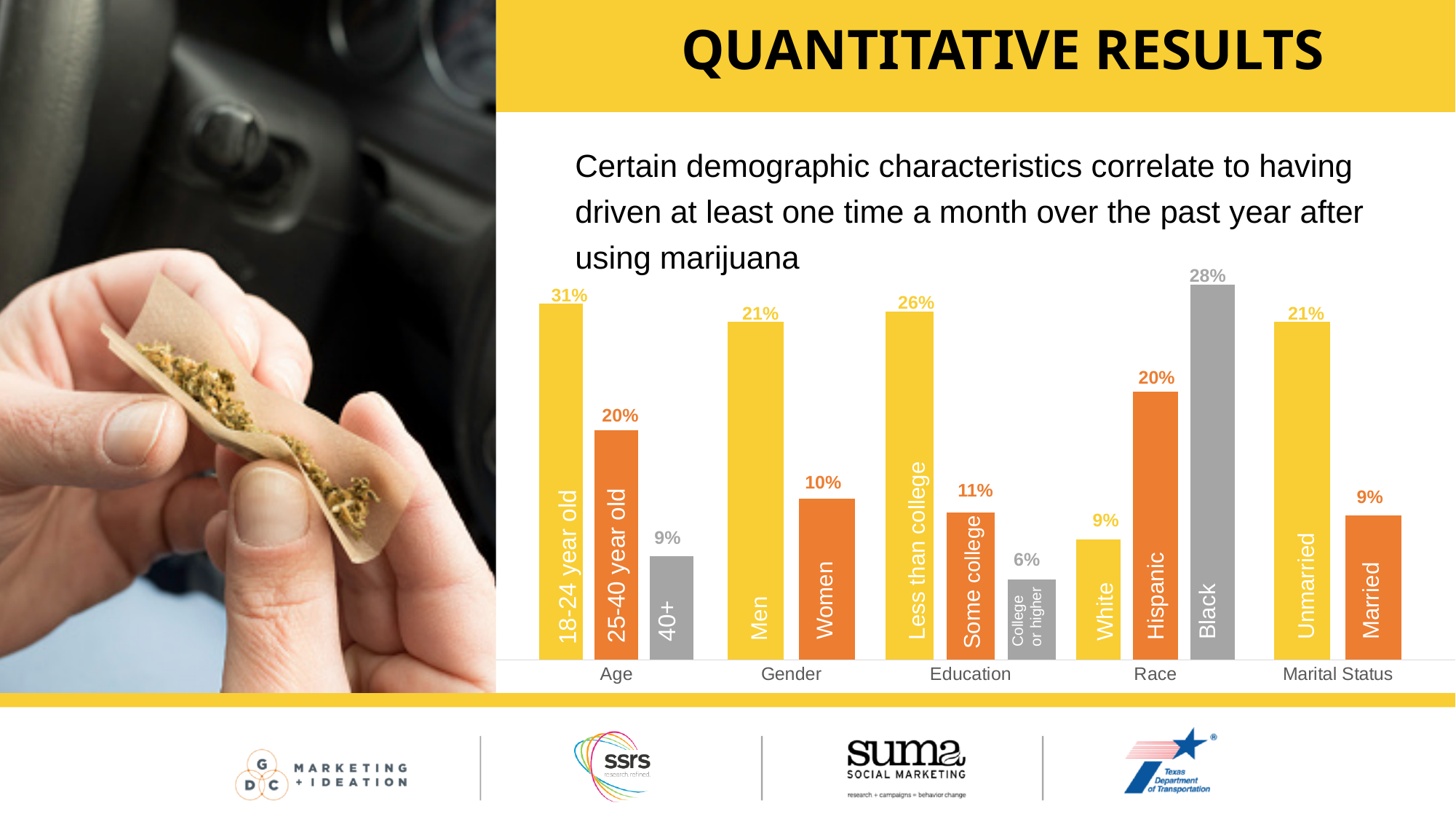
How many demographic groups are labelled along the x axis? 5 What is the value for 18-24 year olds? 31% What kind of chart is shown on the slide? Bar chart How many bars are plotted on the chart? 13 What is the value for Women? 10% Which is larger, the value for Unmarried or for Married? Unmarried What is the difference between the values for Black and White respondents? 19% Which bar has the highest value on the chart? 18-24 year old Which bar has the lowest value on the chart? College or higher What is the value for Hispanic respondents? 20% What is the value for College or higher? 6% What is the difference between the values for Men and Women? 11%